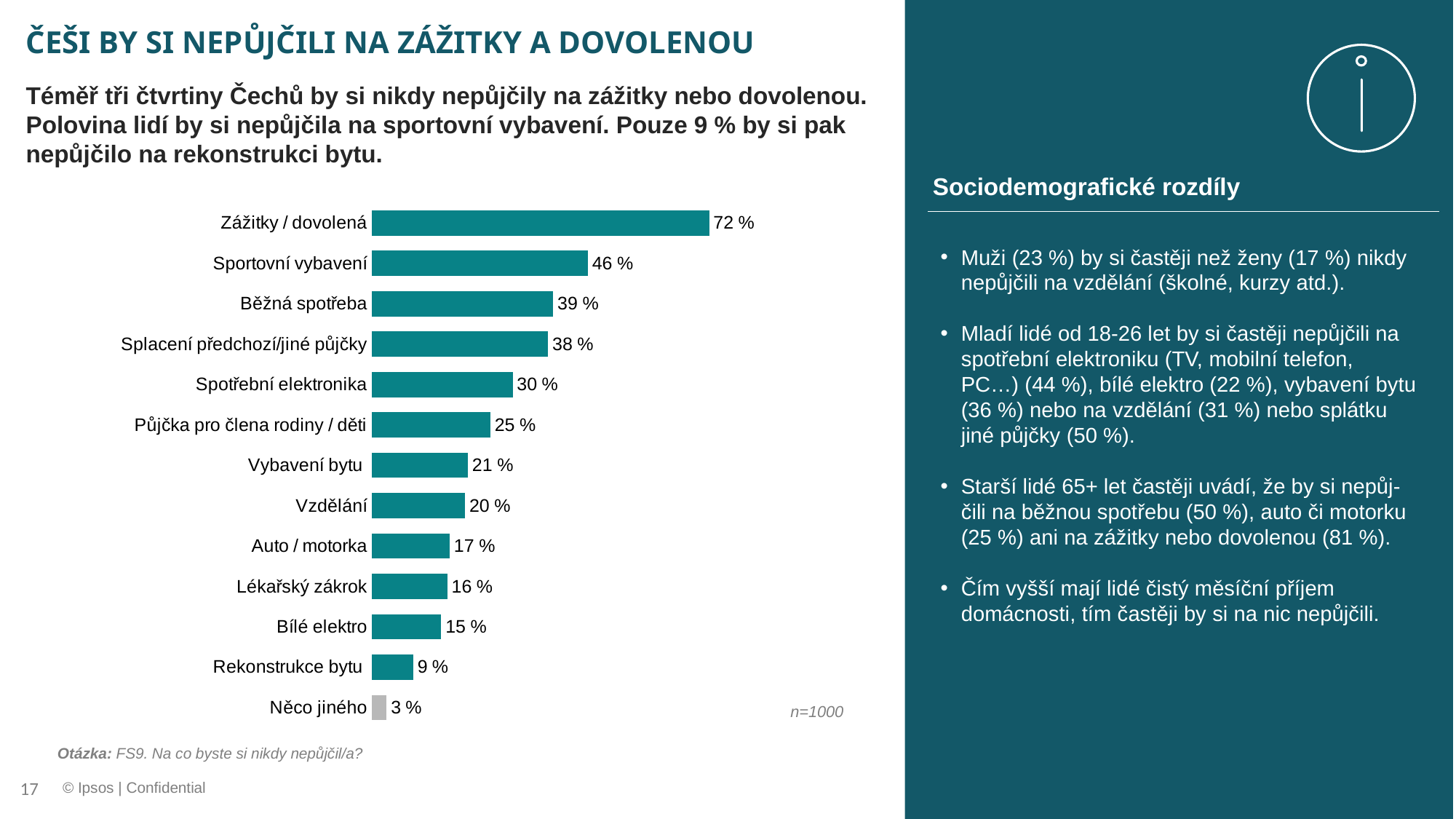
How many categories are shown in the chart? 13 Which category has the lowest value? Něco jiného What kind of chart is shown on the slide? Bar chart Which bar in the chart is coloured grey rather than teal? Něco jiného What is the difference between the values for Zážitky / dovolená and Sportovní vybavení? 26 % Which category has the highest value? Zážitky / dovolená Which is larger, the value for Vybavení bytu or the value for Auto / motorka? Vybavení bytu What is the value for Zážitky / dovolená? 72 % What is the sample size shown next to the chart? n=1000 What is the value for Splacení předchozí/jiné půjčky? 38 % What is the value for Rekonstrukce bytu? 9 % What is the difference between the values for Běžná spotřeba and Spotřební elektronika? 9 %